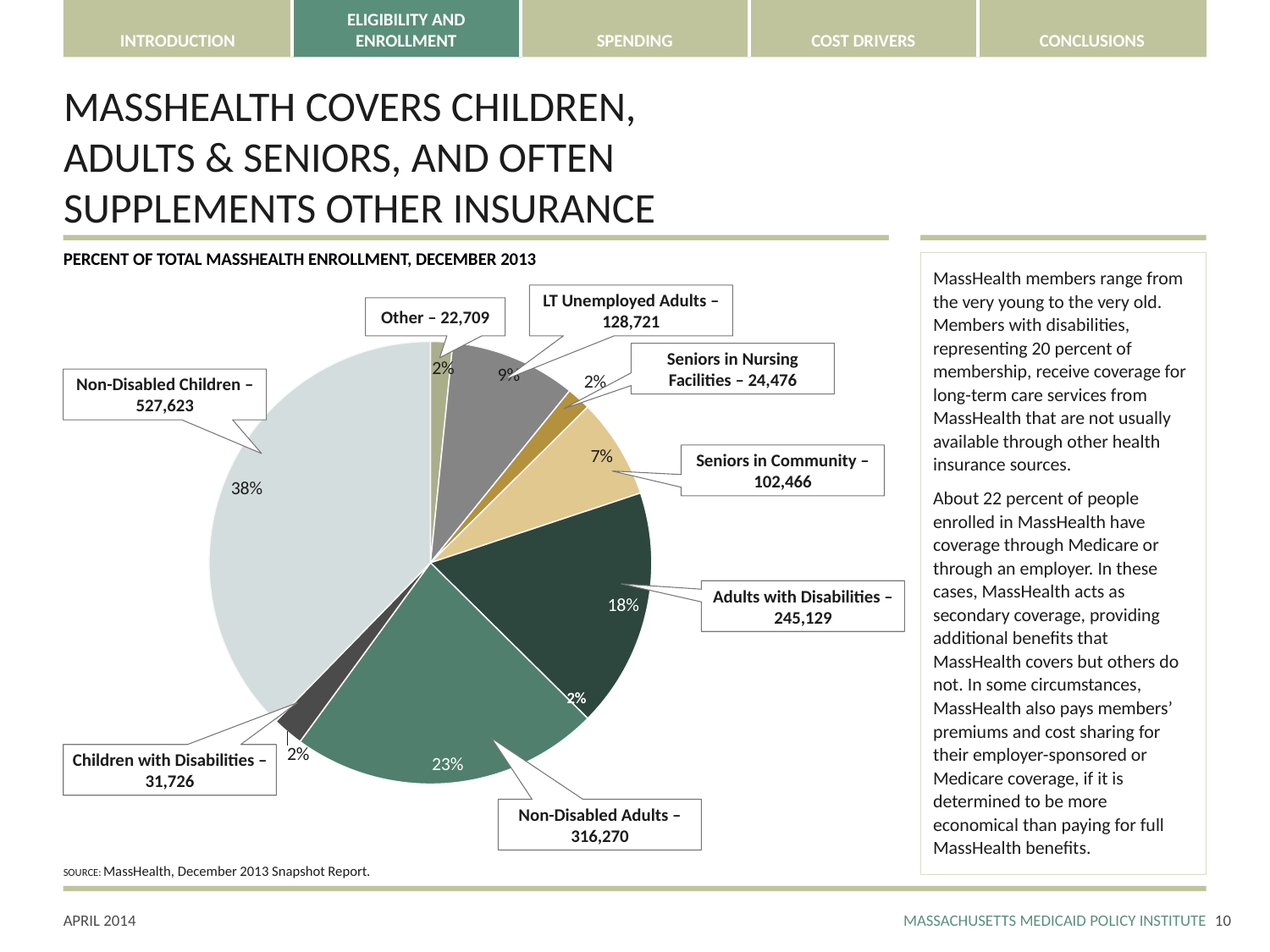
Which has a larger enrollment count, Seniors in Community or LT Unemployed Adults? LT Unemployed Adults What is the enrollment count for Adults with Disabilities? 245,129 What percentage of total MassHealth enrollment is Seniors in Community? 7% Which category has the largest share of MassHealth enrollment? Non-Disabled Children Which category has the smallest enrollment count? Other What is the enrollment count for Non-Disabled Children? 527,623 What kind of chart is shown on the slide? pie chart What is the title of the chart? PERCENT OF TOTAL MASSHEALTH ENROLLMENT, DECEMBER 2013 What is the difference in enrollment between Non-Disabled Adults and Adults with Disabilities? 71,141 What percentage of total MassHealth enrollment is Non-Disabled Adults? 23% What percentage of total MassHealth enrollment is LT Unemployed Adults? 9% What is the enrollment count for Seniors in Nursing Facilities? 24,476